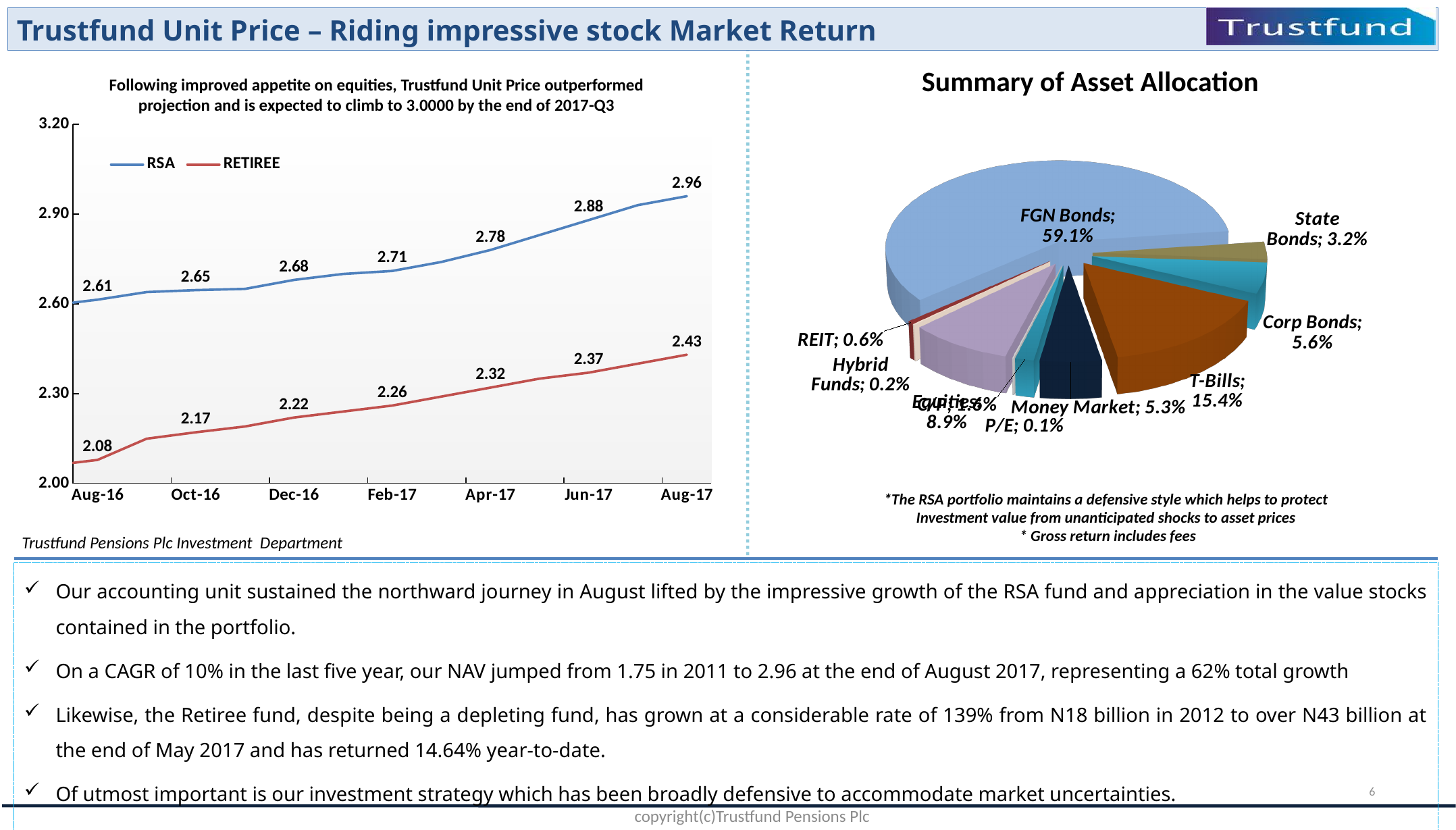
What kind of chart is the chart on the left of the slide? Line chart What kind of chart is the 'Summary of Asset Allocation' chart? Pie chart In the 'Summary of Asset Allocation' chart, what share do FGN Bonds have? 59.1% In the left chart, by how much did the RSA value increase from Aug-16 to Aug-17? 0.35 In the 'Summary of Asset Allocation' chart, what is the share of T-Bills? 15.4% In the left chart, what is the RETIREE value at Aug-16? 2.08 In the left chart, does the RETIREE line rise or fall from Aug-16 to Aug-17? Rise In the left chart, what is the RSA value at Aug-17? 2.96 In the 'Summary of Asset Allocation' chart, which is larger, Corp Bonds or Money Market? Corp Bonds In the left chart, how many series does the legend list? 2 In the left chart, what is the difference between the RSA and RETIREE values at Aug-17? 0.53 In the 'Summary of Asset Allocation' chart, which asset class has the largest slice? FGN Bonds